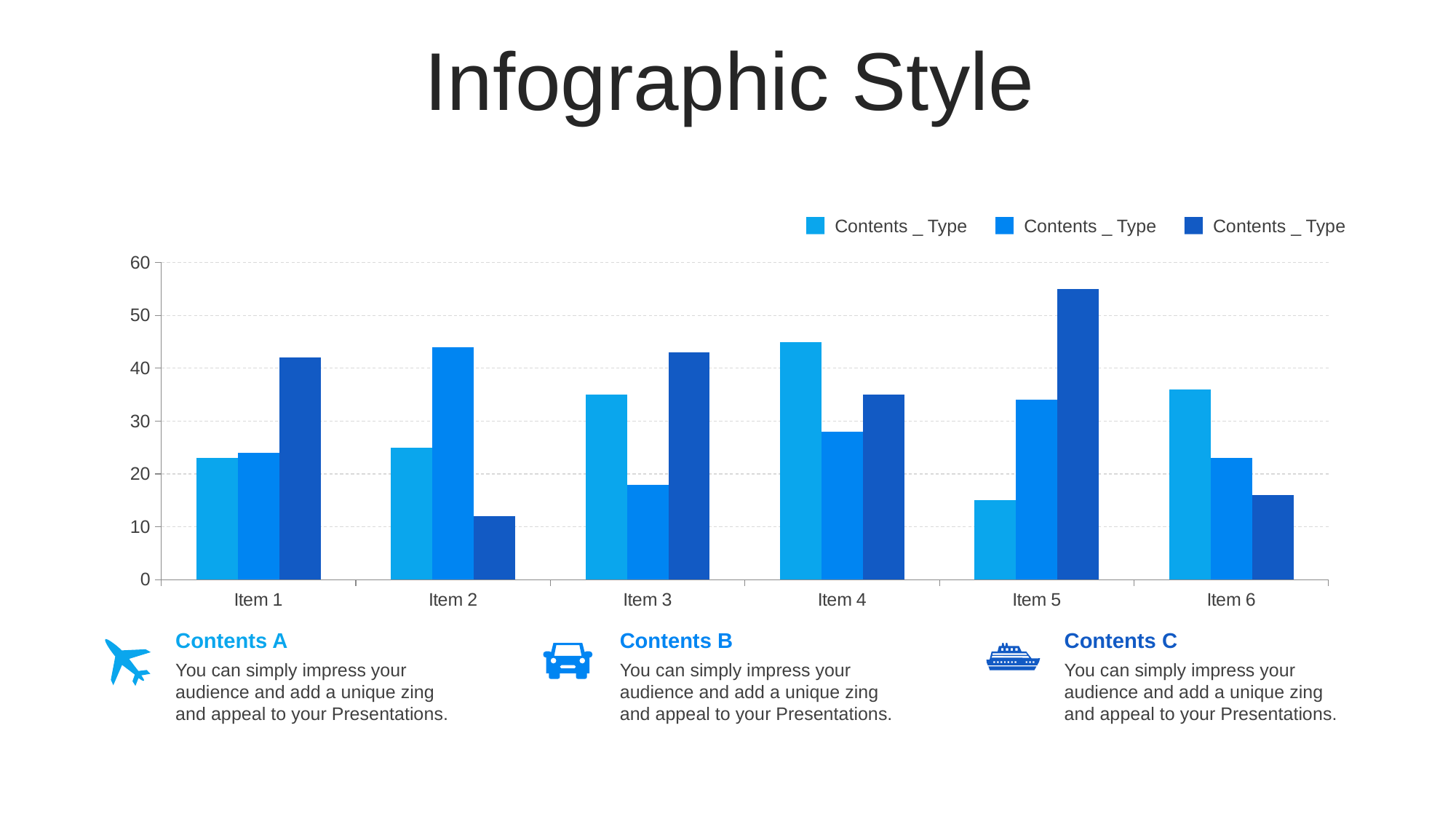
Is the value of the darkest blue bar for Item 2 greater or less than 20? less Is the value of the medium blue bar for Item 5 greater or less than 30? greater For Item 3, which is larger: the darkest blue bar or the medium blue bar? the darkest blue bar Is the value of the lightest blue bar for Item 4 greater or less than 40? greater Which item contains the tallest bar in the chart? Item 5 How many series does the chart's legend list? 3 Among the darkest blue bars, which item has the lowest value? Item 2 How many categories (items) are shown on the x axis of the chart? 6 What is the highest tick value shown on the chart's y axis? 60 Which is larger: the lightest blue bar for Item 4 or the lightest blue bar for Item 1? Item 4 What kind of chart is shown on the slide? bar chart